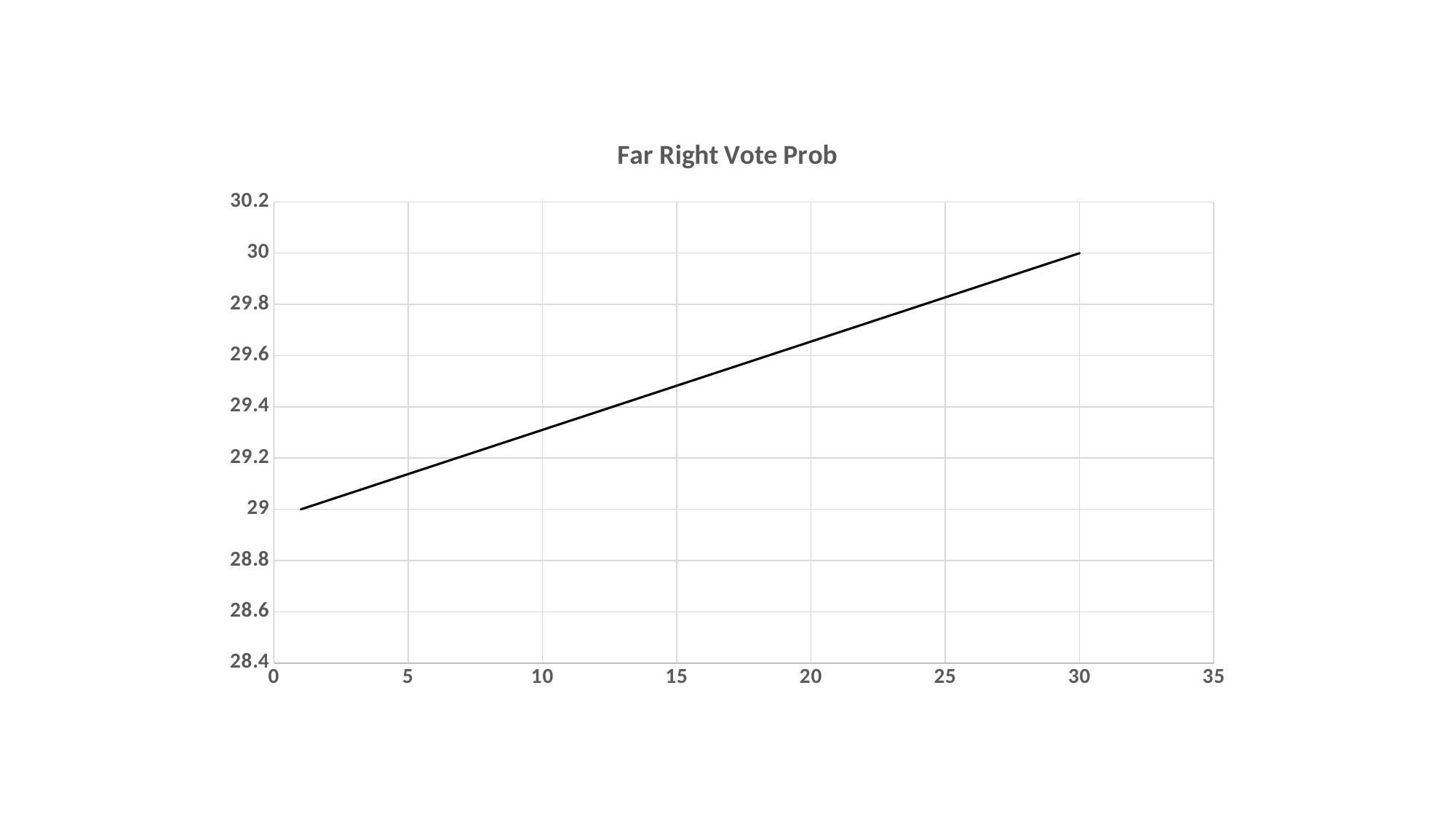
Is the value of the line at x = 25 greater or less than 30? less Is the value of the line at x = 15 greater or less than 29.6? less What kind of chart is shown on the slide? line chart What is the value of the line at x = 30? 30 Is the value of the line at x = 20 greater or less than 29.8? less At which x value does the line reach its highest point? 30 Does the line rise or fall as the x axis increases? rises By how much does the line's value at x = 30 exceed its value at the left end? 1 Which is larger, the value of the line at x = 10 or at x = 25? x = 25 What is the title of the chart? Far Right Vote Prob What is the value of the line at its left end? 29